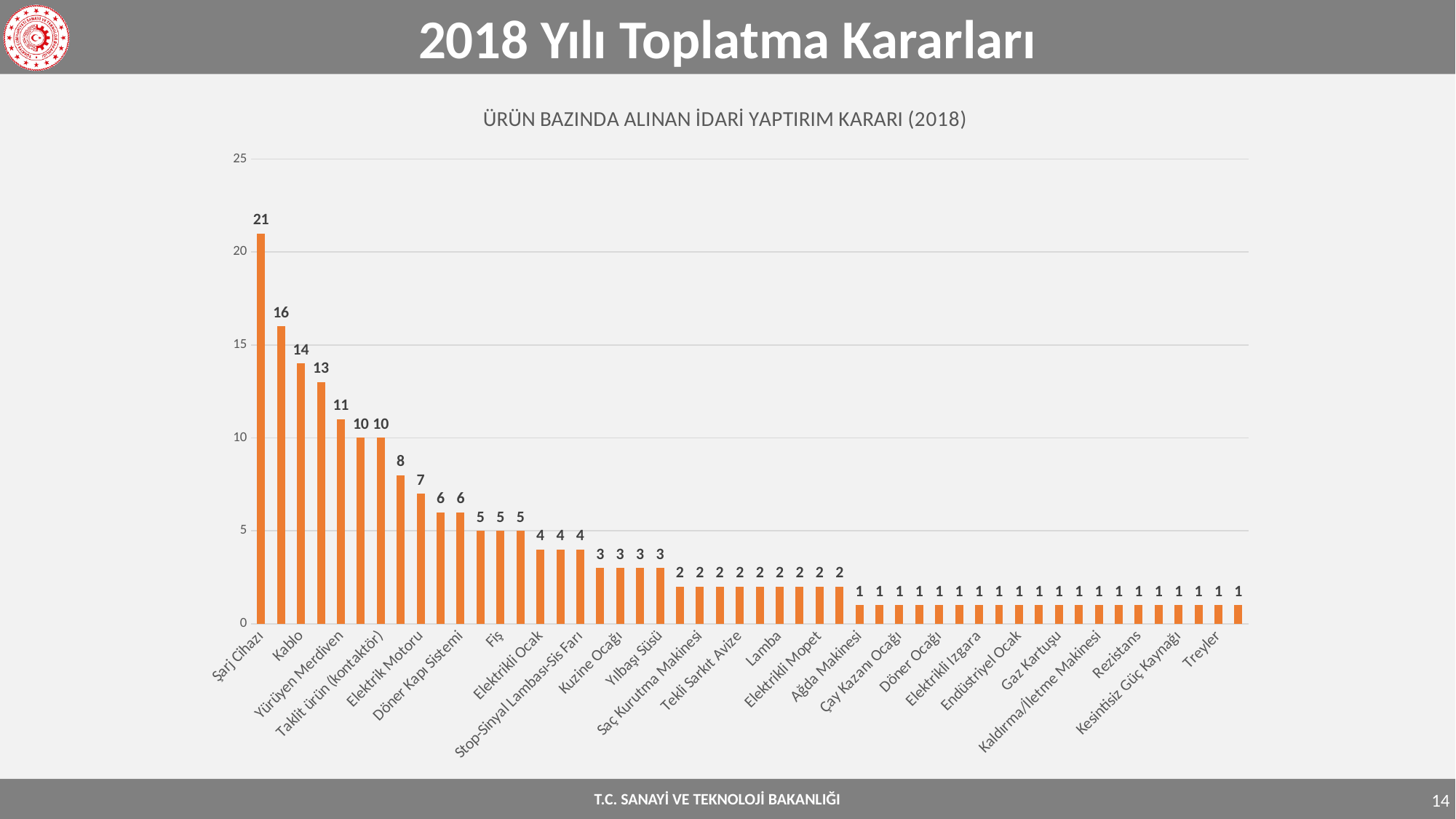
What is the value for Yürüyen Merdiven? 11 Which product has the highest number of decisions? Şarj Cihazı What is the value for Elektrik Motoru? 7 What type of chart is shown on the slide? bar chart What is the difference between the values for Şarj Cihazı and Kablo? 7 What is the value for Kablo? 14 Which is larger, the value for Kablo or the value for Yürüyen Merdiven? Kablo What is the value for Şarj Cihazı? 21 Is the value for Şarj Cihazı greater or less than 20? greater What is the title of the chart? ÜRÜN BAZINDA ALINAN İDARİ YAPTIRIM KARARI (2018) What is the value for Treyler? 1 Do the values rise or fall from left to right along the x axis? fall